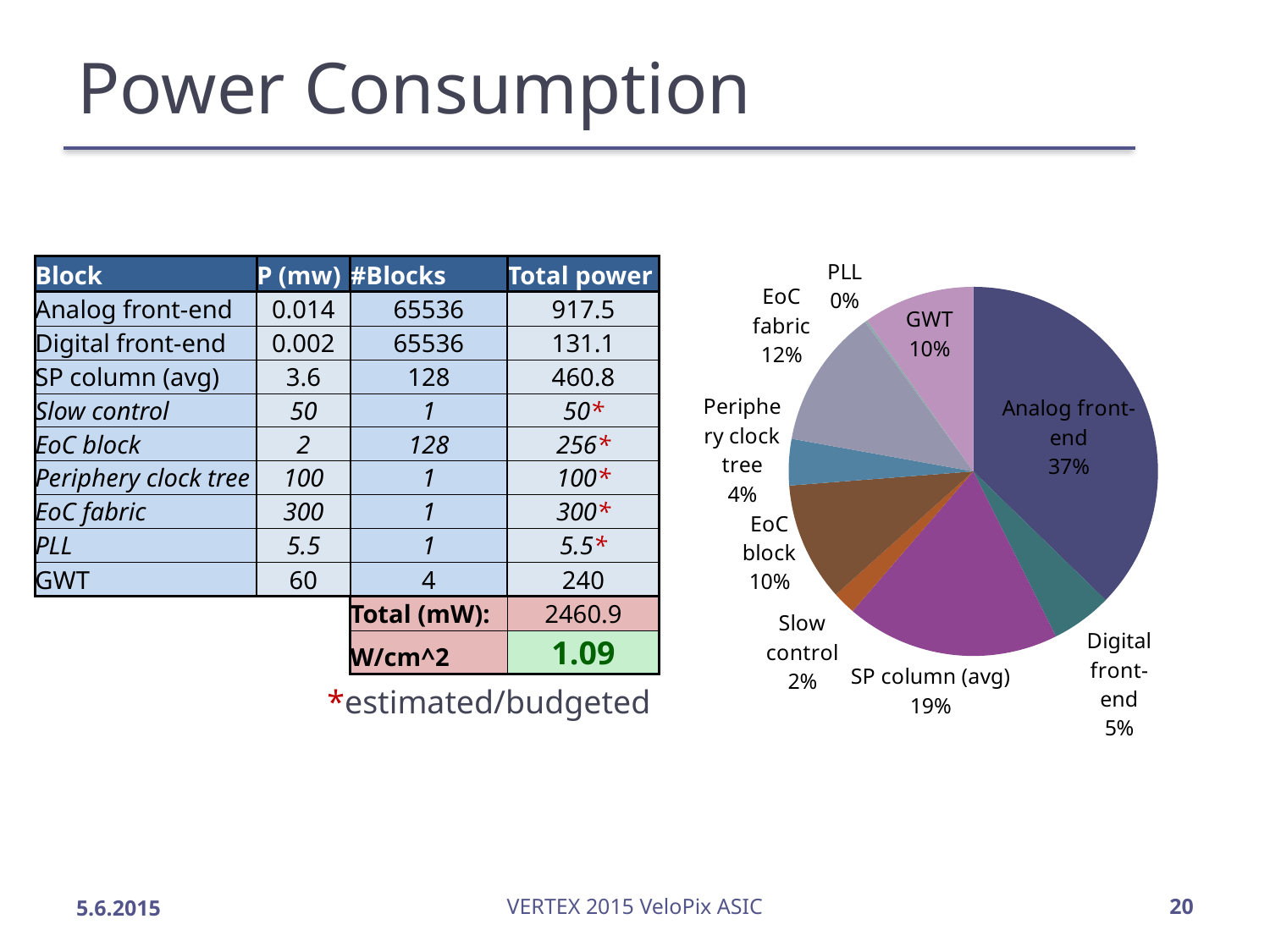
What is the difference in percentage points between the Analog front-end slice and the SP column (avg) slice? 18 What is the title of the slide containing the pie chart? Power Consumption How many slices does the pie chart have? 9 What share of the pie does EoC fabric have? 12% Which slice of the pie is the smallest? PLL What kind of chart is shown on the slide? pie chart Which slice of the pie is the largest? Analog front-end Which is larger in the pie chart, EoC fabric or Digital front-end? EoC fabric What share of the pie does PLL have? 0% What share of the pie does Analog front-end have? 37%